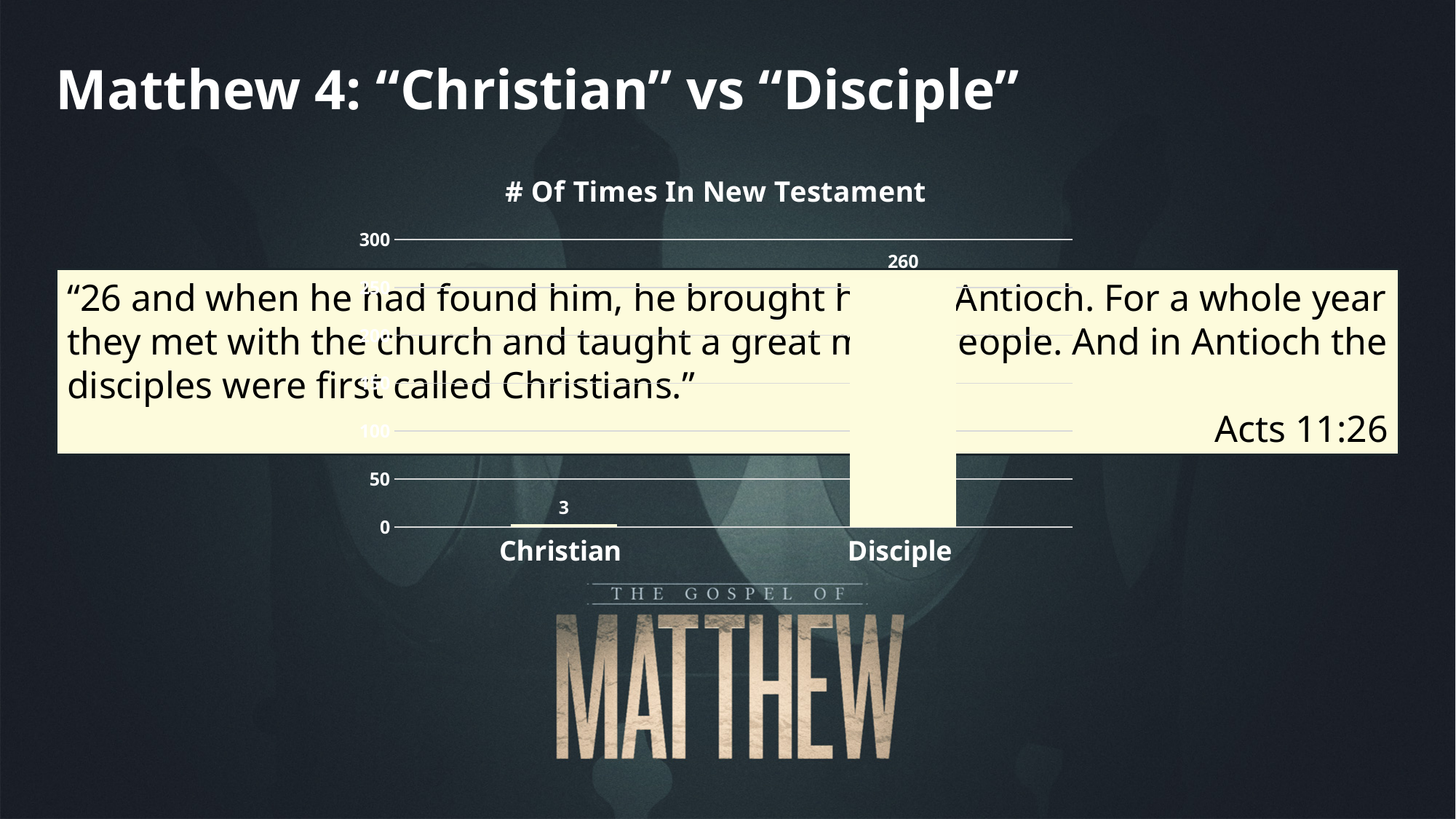
How many categories are shown in the chart? 2 Which category has the highest value in the chart? Disciple What kind of chart is shown on the slide? bar chart What is the value for Disciple in the chart? 260 Which is larger, the value for Christian or the value for Disciple? Disciple What is the highest value shown on the chart's vertical axis? 300 Is the value for Christian greater or less than 50? less What is the value for Christian in the chart? 3 What is the title of the chart? # Of Times In New Testament Which category has the lowest value in the chart? Christian Is the value for Disciple greater or less than 250? greater What is the difference between the values for Disciple and Christian? 257